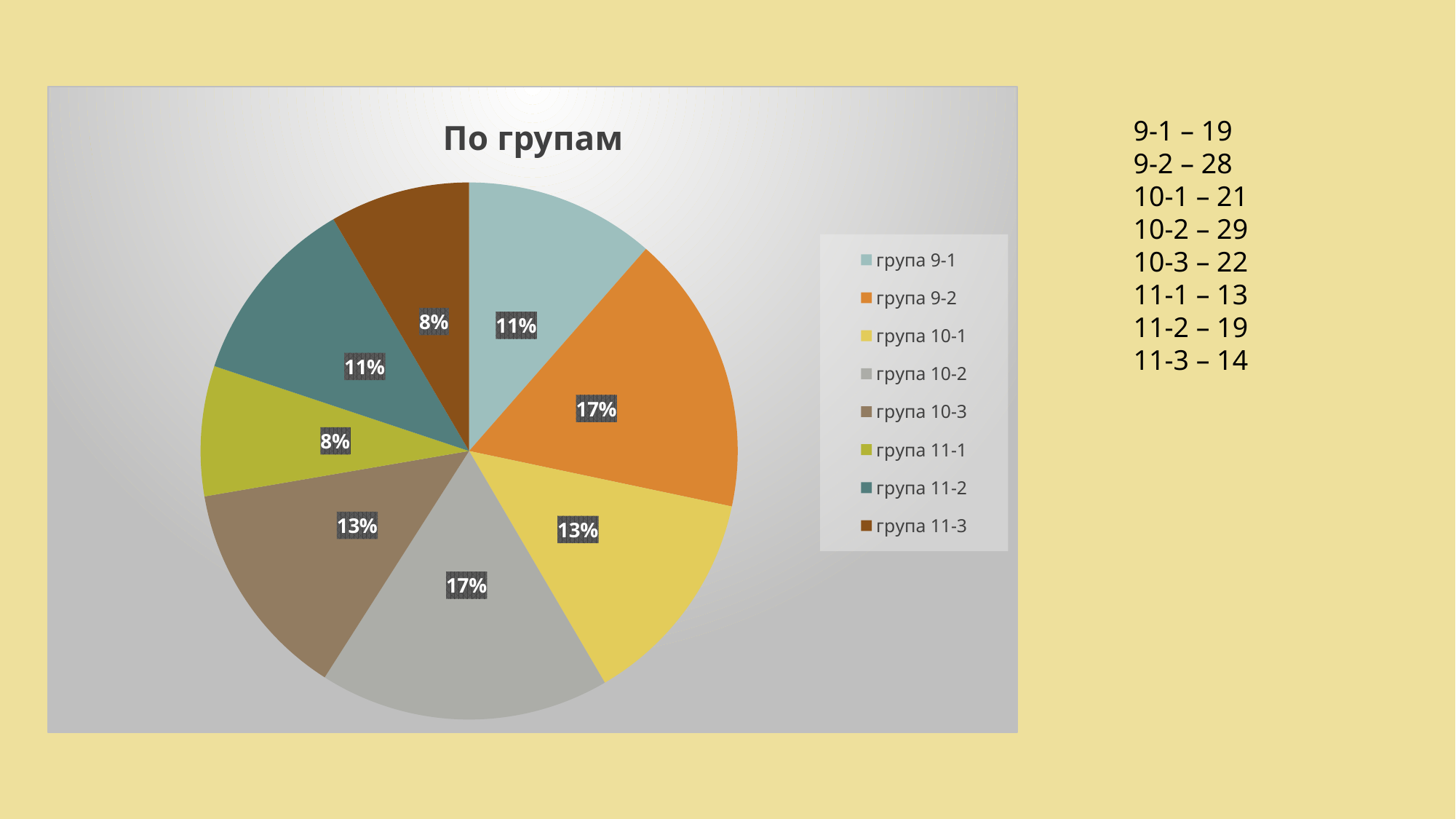
What share of the pie does група 9-2 have? 17% What share of the pie does група 11-3 have? 8% What share of the pie does група 10-2 have? 17% What is the difference in percentage points between the shares of група 10-2 and група 11-2? 6 How many slices does the pie chart have? 8 What is the title of the chart? По групам Which legend entry is shown in orange? група 9-2 What type of chart is shown on the slide? pie chart Which has a larger share of the pie, група 9-2 or група 11-1? група 9-2